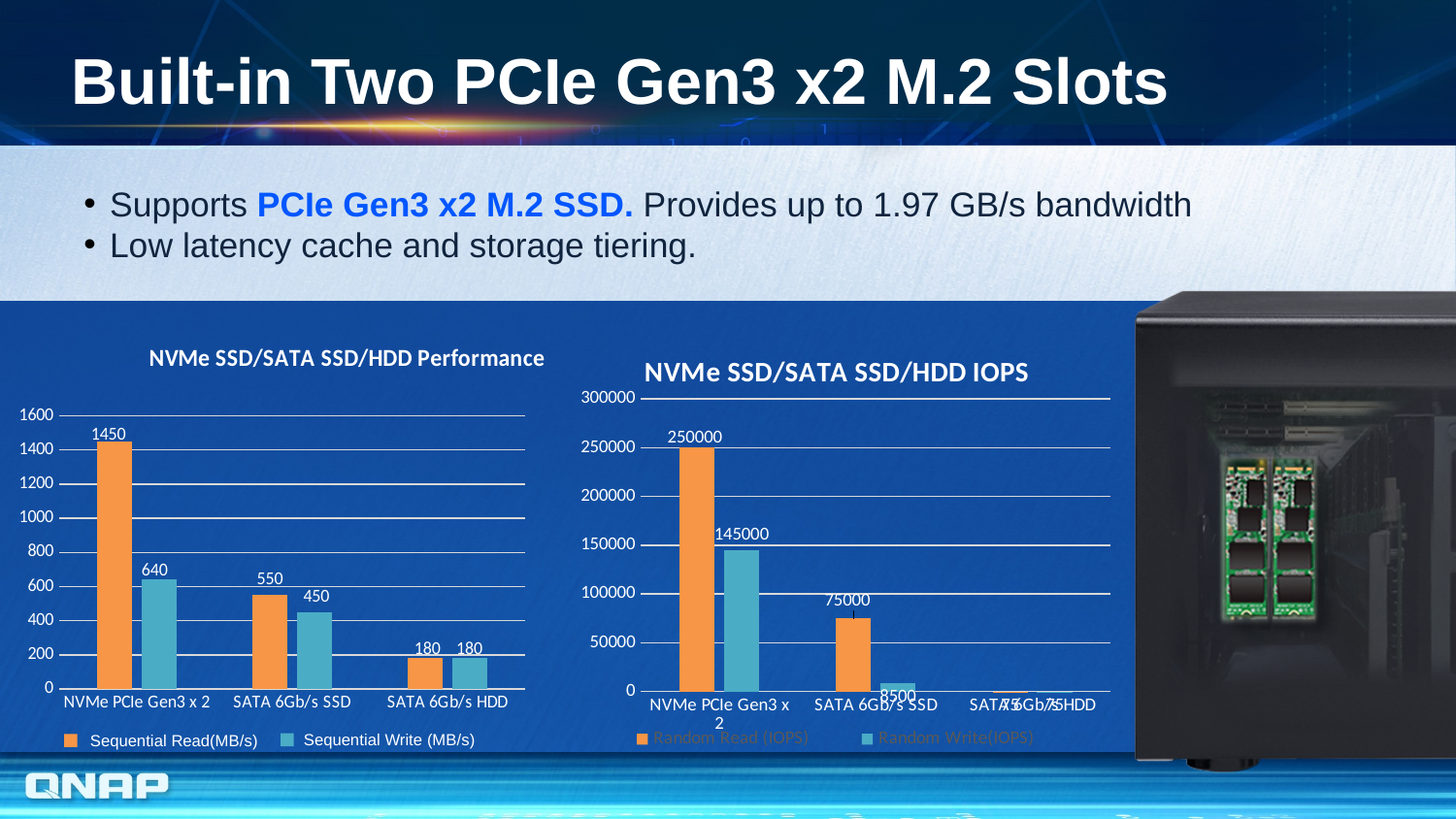
In the NVMe SSD/SATA SSD/HDD Performance chart, which category has the highest Sequential Read(MB/s) value? NVMe PCIe Gen3 x 2 In the NVMe SSD/SATA SSD/HDD IOPS chart, which is larger: the Random Read value for SATA 6Gb/s SSD or the Random Write value for NVMe PCIe Gen3 x 2? Random Write value for NVMe PCIe Gen3 x 2 In the NVMe SSD/SATA SSD/HDD IOPS chart, what is the difference between the Random Read and Random Write values for NVMe PCIe Gen3 x 2? 105000 In the NVMe SSD/SATA SSD/HDD IOPS chart, what is the Random Write(IOPS) value for SATA 6Gb/s SSD? 8500 In the NVMe SSD/SATA SSD/HDD Performance chart, what is the Sequential Write (MB/s) value for SATA 6Gb/s SSD? 450 In the NVMe SSD/SATA SSD/HDD Performance chart, what is the Sequential Read(MB/s) value for NVMe PCIe Gen3 x 2? 1450 In the NVMe SSD/SATA SSD/HDD Performance chart, how many categories are shown on the x axis? 3 In the NVMe SSD/SATA SSD/HDD IOPS chart, what is the Random Read (IOPS) value for NVMe PCIe Gen3 x 2? 250000 In the NVMe SSD/SATA SSD/HDD Performance chart, what is the Sequential Read(MB/s) value for SATA 6Gb/s HDD? 180 In the NVMe SSD/SATA SSD/HDD Performance chart, how many series does the legend list? 2 In the NVMe SSD/SATA SSD/HDD Performance chart, what is the difference between the Sequential Read and Sequential Write values for NVMe PCIe Gen3 x 2? 810 What kind of chart is the NVMe SSD/SATA SSD/HDD IOPS chart? Bar chart